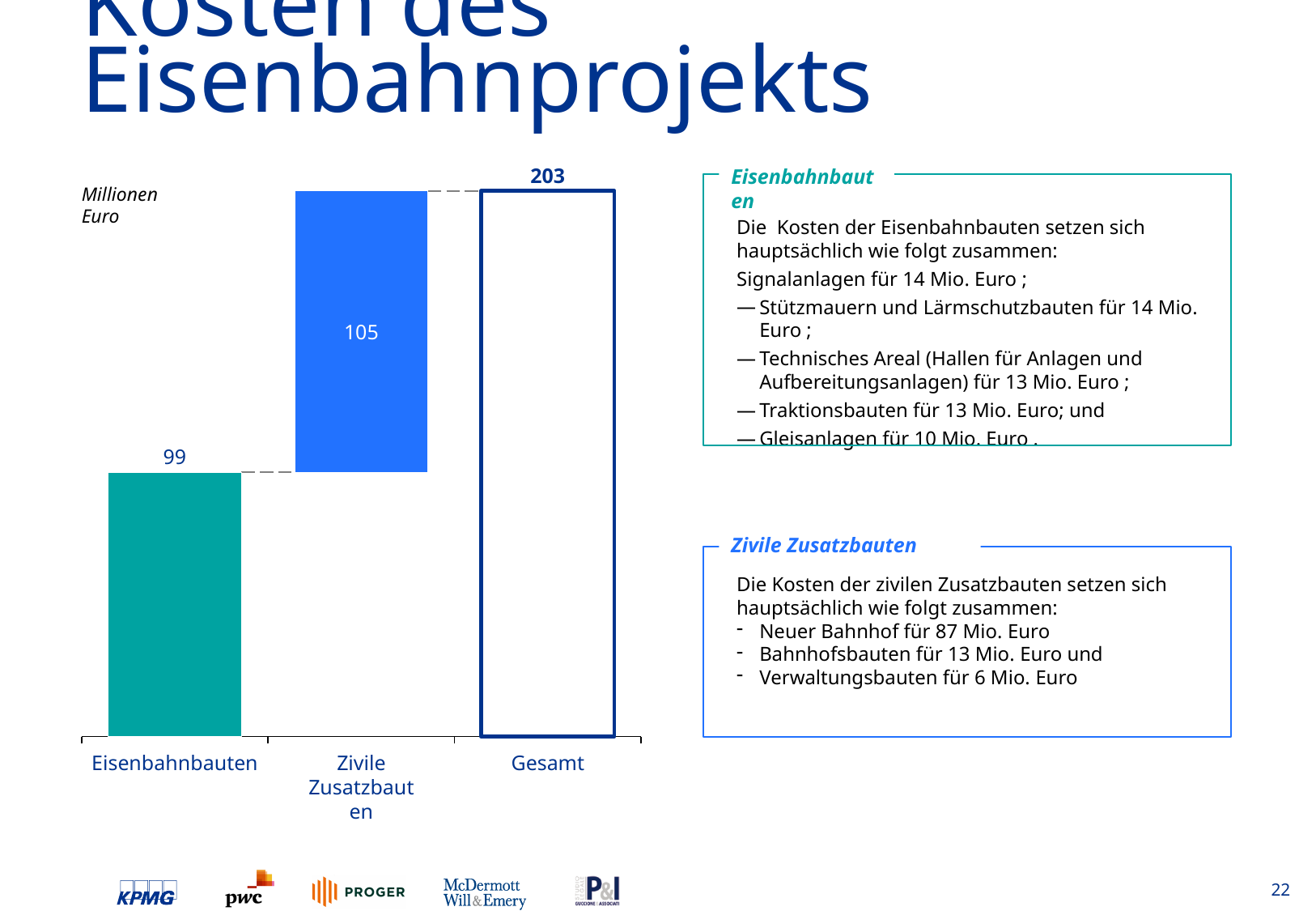
What is the difference between the values for Zivile Zusatzbauten and Eisenbahnbauten? 6 What is the title of the slide containing the chart? Kosten des Eisenbahnprojekts Which category in the chart has the lowest value? Eisenbahnbauten What is the difference between the Gesamt value and the Eisenbahnbauten value? 104 What kind of chart is shown on the slide? Bar chart (waterfall) Which of the two components, Eisenbahnbauten or Zivile Zusatzbauten, has the larger value? Zivile Zusatzbauten How many categories are shown on the x axis of the chart? 3 What is the value shown for Zivile Zusatzbauten in the chart? 105 Which category in the chart has the highest value? Gesamt What is the value shown for Gesamt in the chart? 203 What unit is indicated for the values in the chart? Millionen Euro What is the value shown for Eisenbahnbauten in the chart? 99